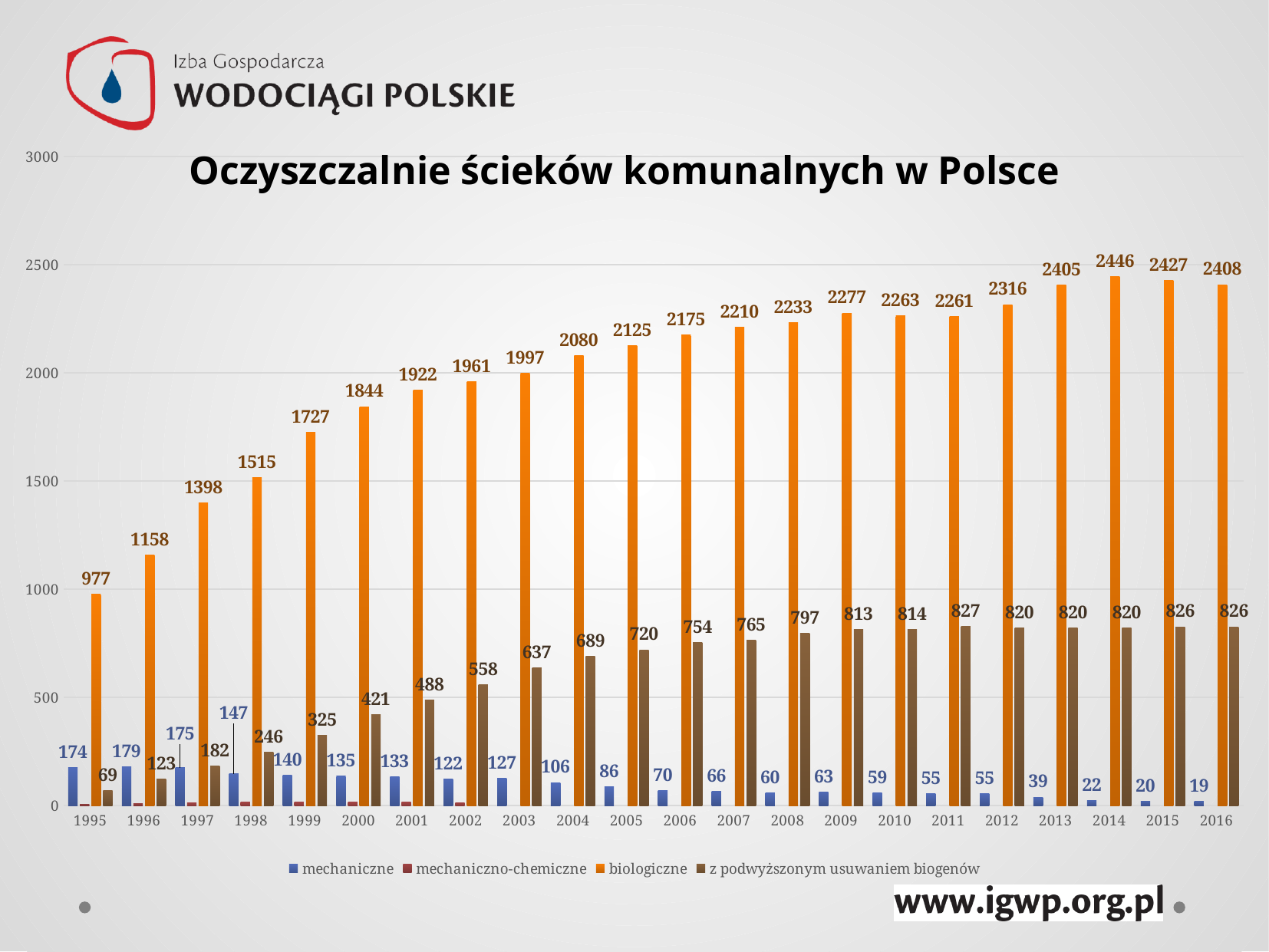
In which year is the mechaniczne value lowest? 2016 What is the value for z podwyższonym usuwaniem biogenów in 2005? 720 What is the value for mechaniczne in 1995? 174 How many years are shown on the x axis? 22 Which is larger, the z podwyższonym usuwaniem biogenów value in 2000 or the mechaniczne value in 2000? z podwyższonym usuwaniem biogenów (421) What is the difference between the biologiczne values in 2016 and 1995? 1431 Does the mechaniczne series rise or fall from 1999 to 2016? fall In which year is the biologiczne value highest? 2014 What type of chart is shown on the slide? bar chart What is the value for biologiczne in 2014? 2446 What is the title of the chart? Oczyszczalnie ścieków komunalnych w Polsce How many series does the legend list? 4